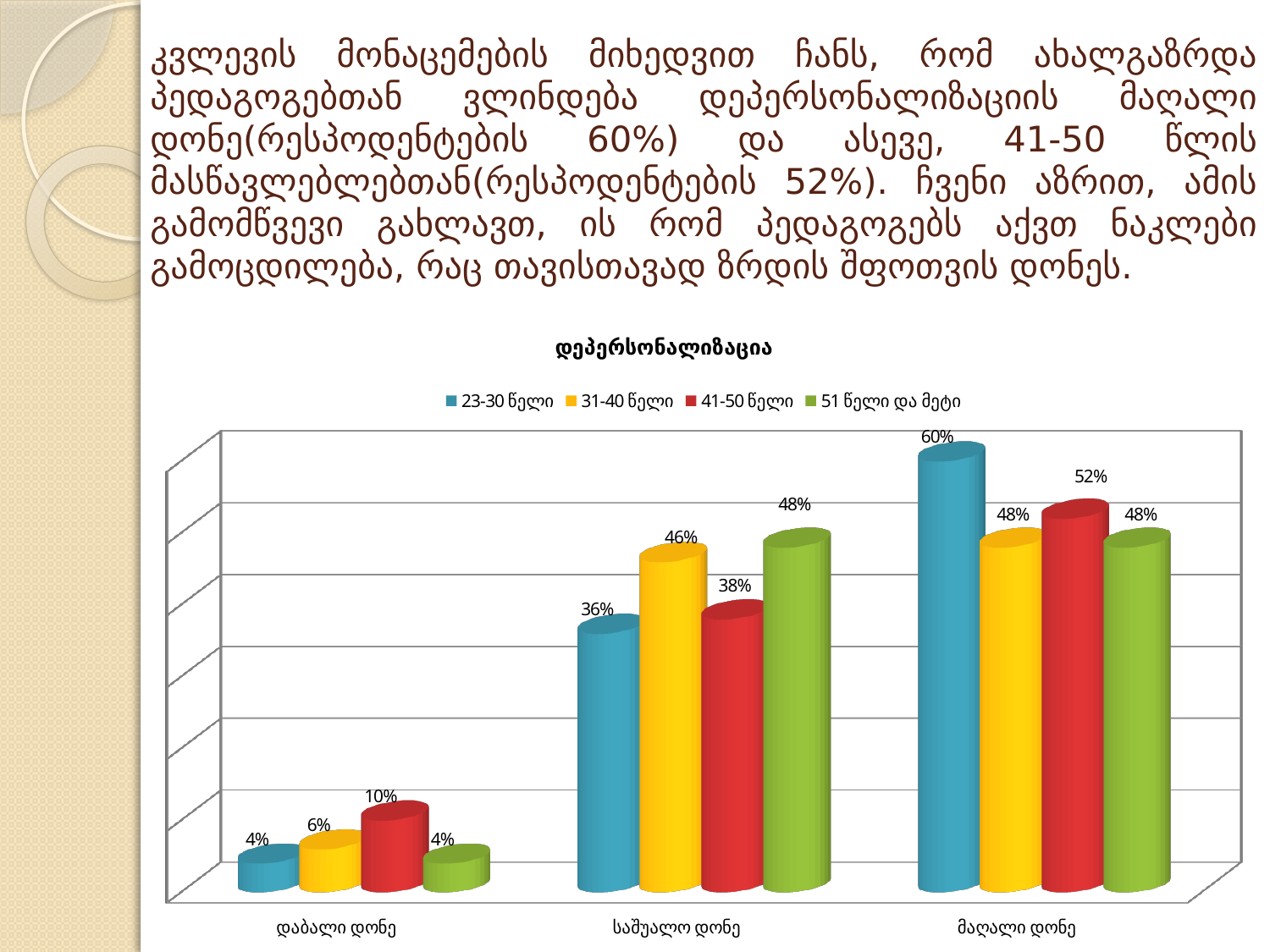
How many categories are shown on the x axis? 3 In the საშუალო დონე category, which is larger: the 31-40 წელი value or the 41-50 წელი value? 31-40 წელი What kind of chart is shown on the slide? bar chart Which series has the lowest value in the საშუალო დონე category? 23-30 წელი What is the title of the chart? დეპერსონალიზაცია How many series does the legend list? 4 What is the value for the 41-50 წელი series in the დაბალი დონე category? 10% What is the value for the 23-30 წელი series in the მაღალი დონე category? 60% Do the values for the 23-30 წელი series rise or fall from დაბალი დონე to მაღალი დონე? rise What is the difference between the 41-50 წელი and 31-40 წელი values in the მაღალი დონე category? 4% Which series has the highest value in the მაღალი დონე category? 23-30 წელი What is the value for the 51 წელი და მეტი series in the საშუალო დონე category? 48%